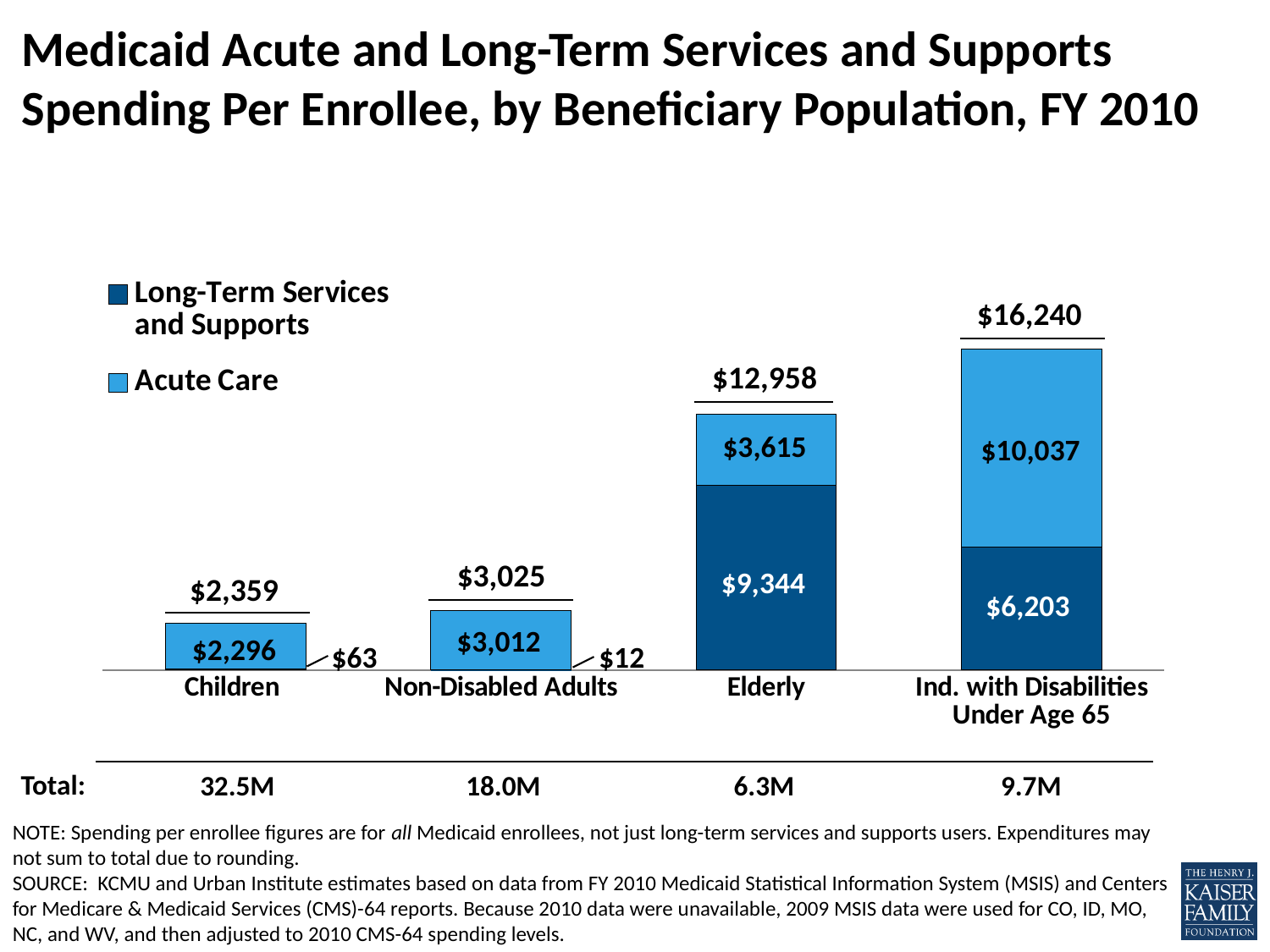
What is the total spending per enrollee for the Elderly? $12,958 Which beneficiary population has the lowest total spending per enrollee? Children Which beneficiary population has the highest total spending per enrollee? Ind. with Disabilities Under Age 65 How many series does the legend list? 2 What kind of chart is shown on the slide? Stacked bar chart How many beneficiary populations are shown on the chart? 4 What is the Acute Care spending per enrollee for Ind. with Disabilities Under Age 65? $10,037 What is the Long-Term Services and Supports spending per enrollee for the Elderly? $9,344 What is the Long-Term Services and Supports spending per enrollee for Non-Disabled Adults? $12 Which is larger for the Elderly: Acute Care spending or Long-Term Services and Supports spending per enrollee? Long-Term Services and Supports What is the Acute Care spending per enrollee for Children? $2,296 What is the difference between the Acute Care spending per enrollee for Non-Disabled Adults and for Children? $716